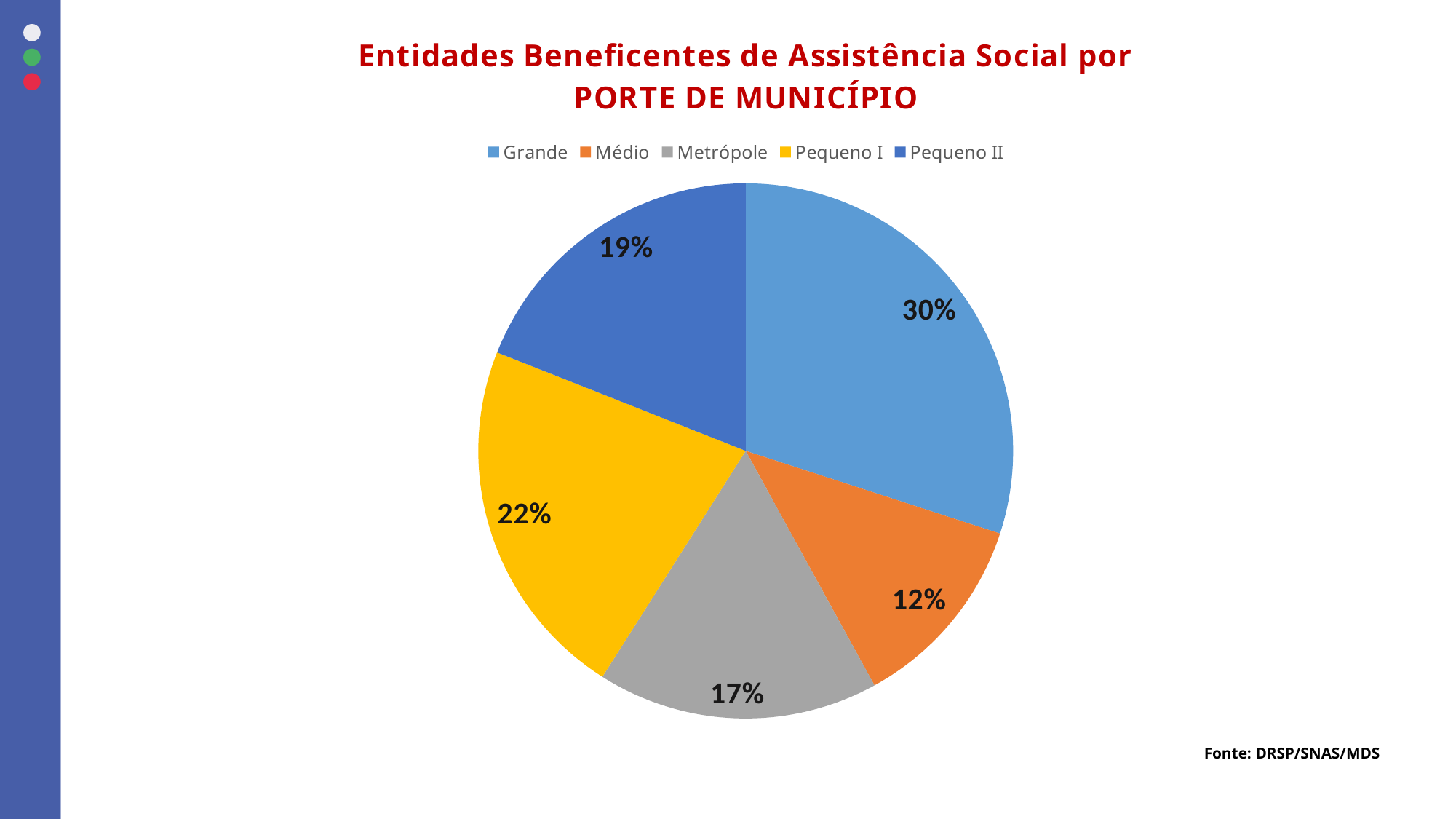
What share of the pie does Médio represent? 12% Which category has the smallest slice of the pie? Médio How many categories are shown in the pie chart? 5 Which is larger, the share for Pequeno I or the share for Pequeno II? Pequeno I What share of the pie does Pequeno I represent? 22% Which category has the largest slice of the pie? Grande What kind of chart is shown on the slide? Pie chart What share of the pie does Pequeno II represent? 19% What colour is the slice for Pequeno I? Yellow What is the difference in percentage points between Grande and Médio? 18 What share of the pie does Grande represent? 30% What share of the pie does Metrópole represent? 17%